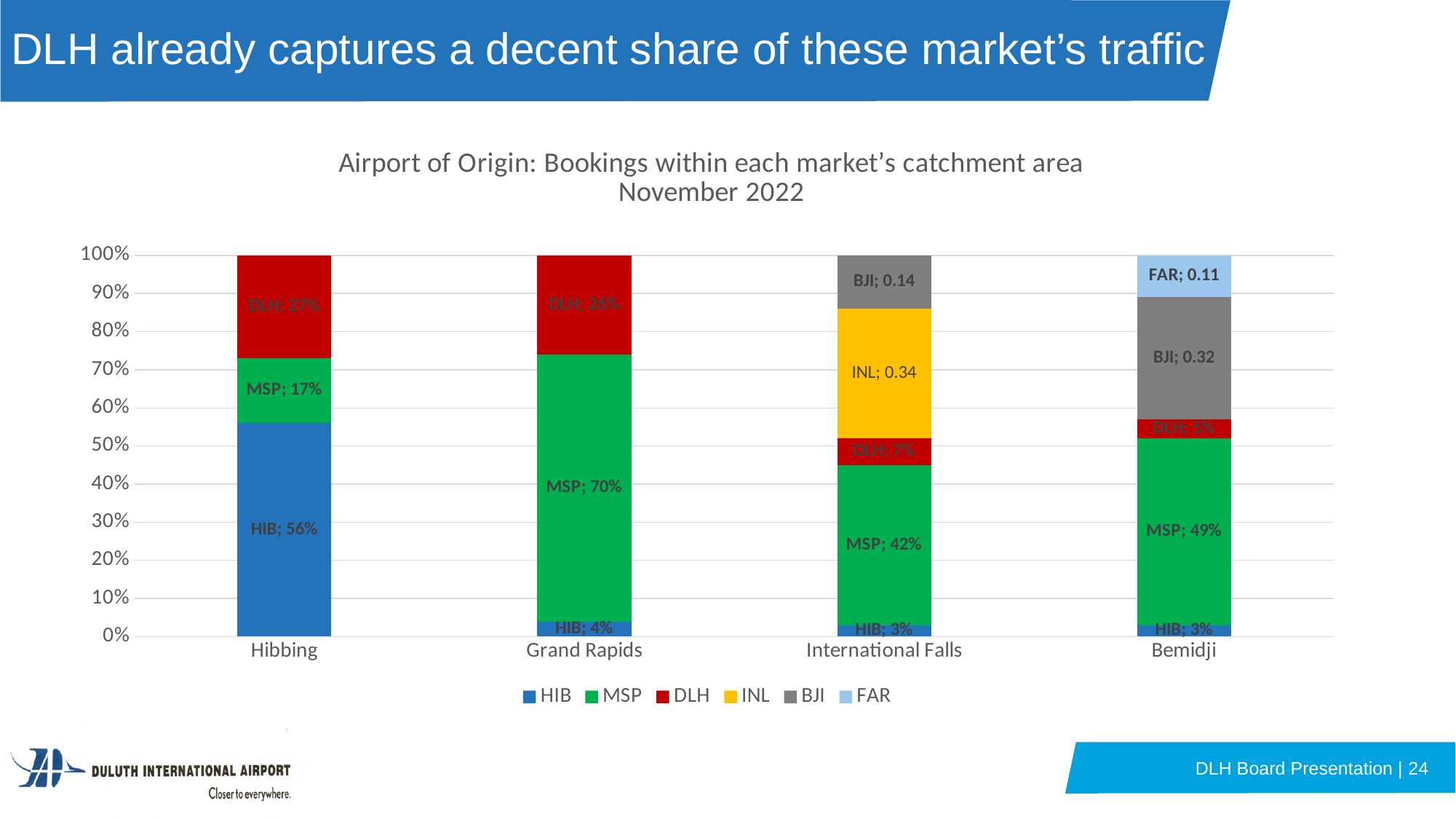
What is the difference between the MSP share for Grand Rapids and the MSP share for Bemidji? 21% What is the INL value for International Falls? 0.34 What is the MSP share for Grand Rapids? 70% How many markets (categories) are shown on the x axis? 4 How many series does the legend list? 6 What type of chart is shown on the slide? stacked bar chart What is the HIB share for Hibbing? 56% What is the BJI value for Bemidji? 0.32 Which is larger, the DLH share for Hibbing or the DLH share for Grand Rapids? Hibbing Which market has the highest DLH share? Hibbing Which market has the lowest MSP share? Hibbing What is the DLH share for Bemidji? 5%